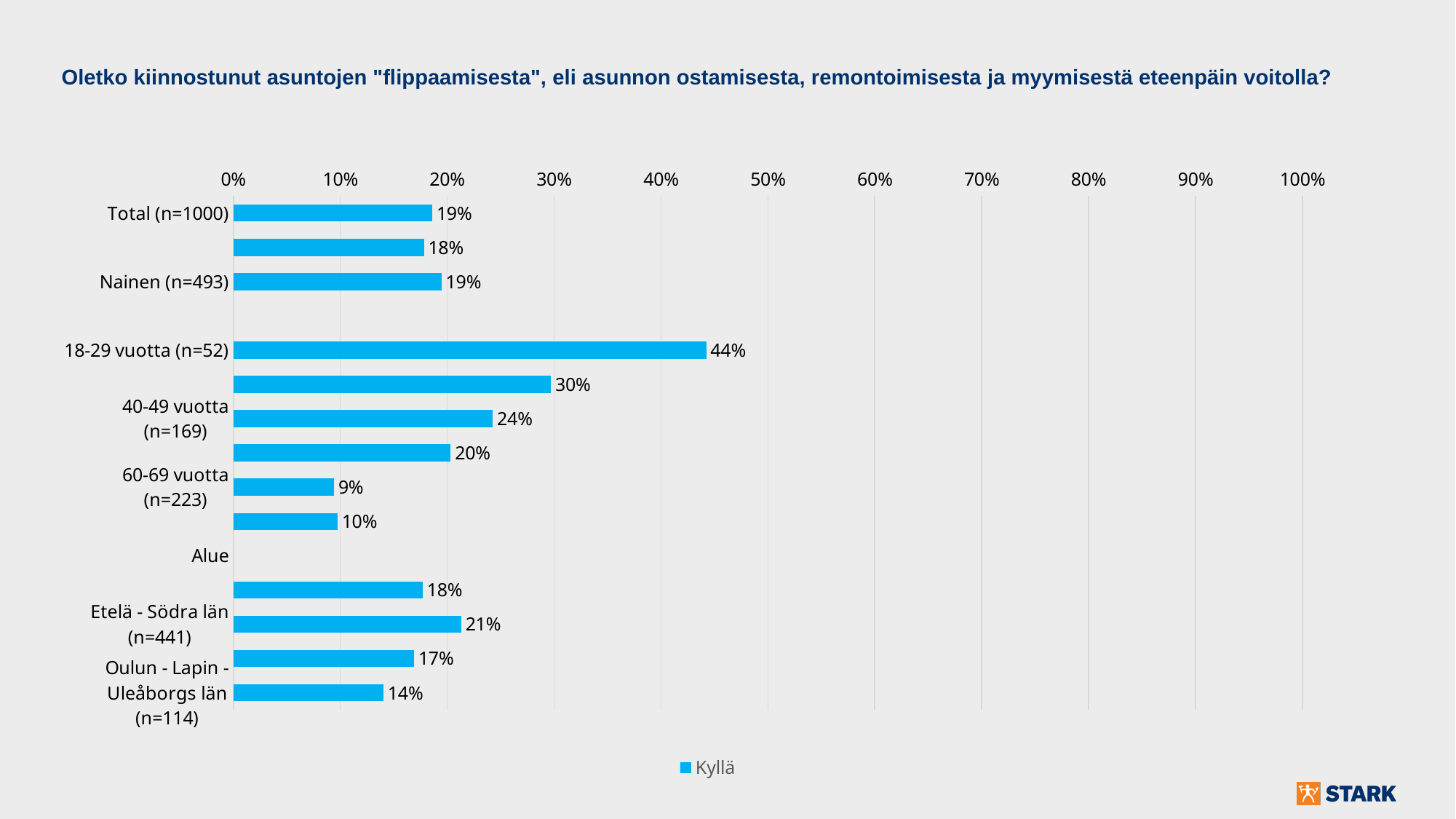
Which category has the lowest value? 60-69 vuotta (n=223) What kind of chart is shown on the slide? bar chart What is the value for Oulun - Lapin - Uleåborgs län (n=114)? 14% What is the value for Total (n=1000)? 19% What is the value for Etelä - Södra län (n=441)? 21% What is the difference between the values for 18-29 vuotta (n=52) and 40-49 vuotta (n=169)? 20% How many series does the legend list? 1 What is the value for 18-29 vuotta (n=52)? 44% Which is larger, the value for Etelä - Södra län (n=441) or the value for Oulun - Lapin - Uleåborgs län (n=114)? Etelä - Södra län (n=441) What is the value for 60-69 vuotta (n=223)? 9% Which category has the highest value? 18-29 vuotta (n=52) Is the value for 18-29 vuotta (n=52) greater or less than 40%? greater